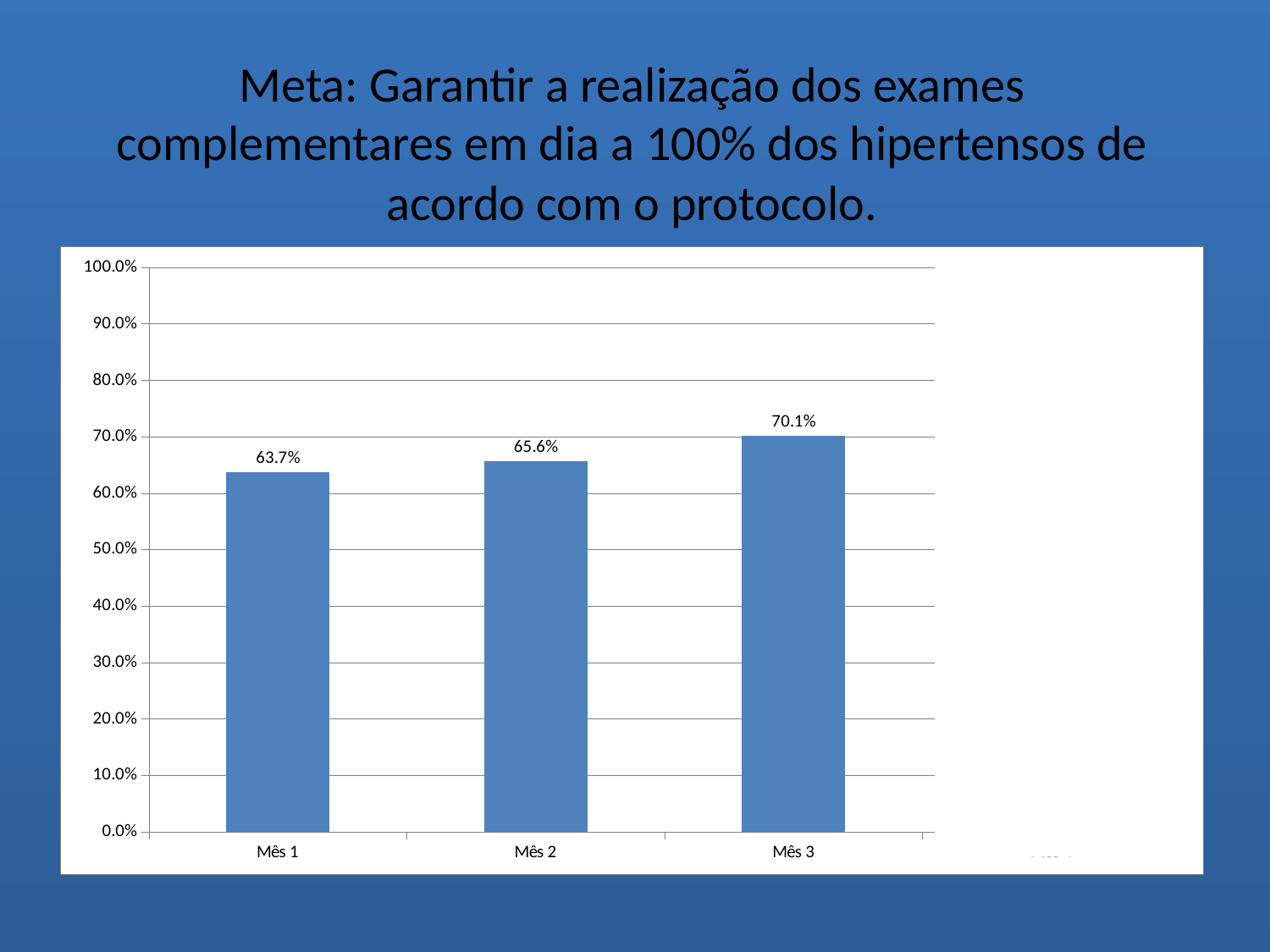
How many bars are shown in the chart? 3 What is the value for Mês 3? 70.1% Which month has the highest value? Mês 3 What kind of chart is shown on the slide? bar chart Which is larger, the value for Mês 2 or the value for Mês 3? Mês 3 Is the value for Mês 3 greater or less than 80.0%? less What is the value for Mês 2? 65.6% Which month has the lowest value? Mês 1 What is the difference between the values for Mês 2 and Mês 1? 1.9% What is the difference between the values for Mês 3 and Mês 1? 6.4% What is the value for Mês 1? 63.7% Do the values rise or fall from Mês 1 to Mês 3? rise